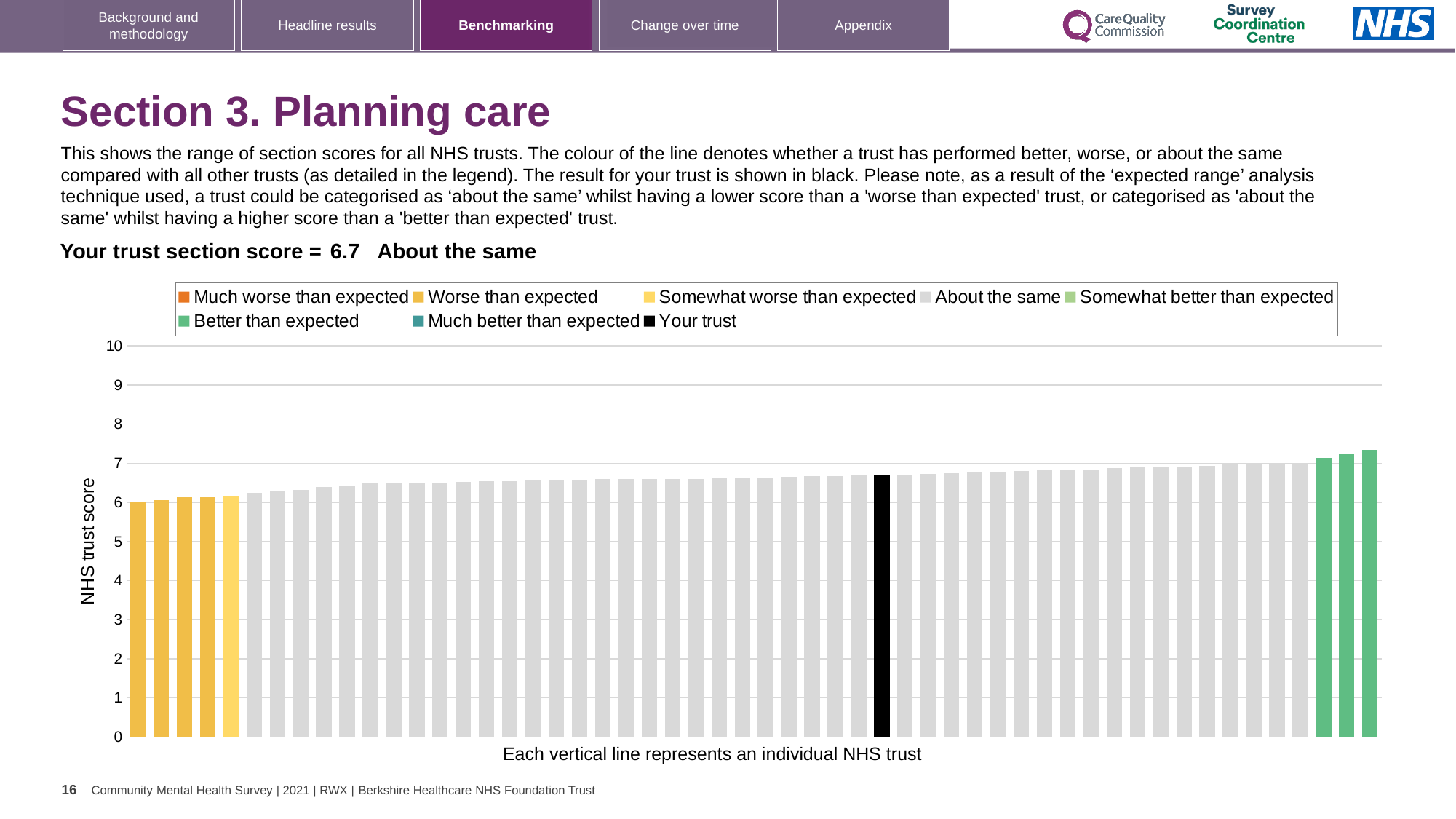
What is the maximum value shown on the vertical axis? 10 How many entries does the chart legend list? 8 Is the value of the highest bar greater or less than 8? less Which category does your trust fall into according to the slide? About the same What is the label on the vertical axis? NHS trust score What is the section score for your trust (the black bar)? 6.7 Is the value of the highest bar greater or less than 7? greater Is the value of the lowest bar greater or less than 5? greater How many bars are coloured black (your trust)? 1 Do the bar values rise or fall from left to right along the x axis? rise How many bars are coloured green (better than expected)? 3 What kind of chart is shown on the slide? bar chart